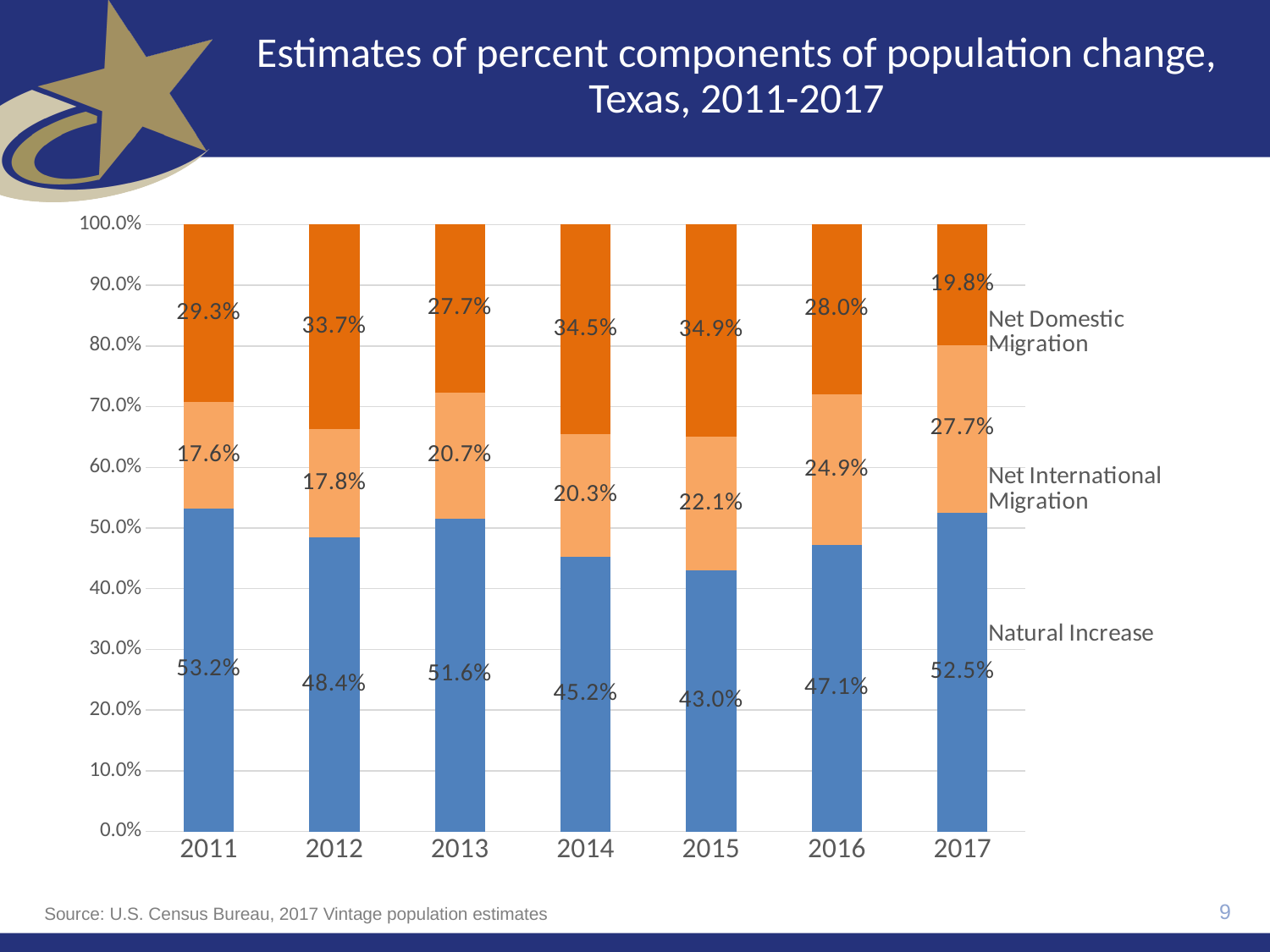
Which year has the highest Natural Increase share? 2011 What kind of chart is shown on the slide? Stacked bar chart Does the Net International Migration share rise or fall from 2013 to 2017? Rise What is the Net International Migration value for 2013? 20.7% What is the Natural Increase value for 2015? 43.0% What is the source cited below the chart? U.S. Census Bureau, 2017 Vintage population estimates Which is larger, the Net International Migration value for 2016 or for 2014? 2016 How many years are shown on the x axis? 7 How many series are shown in the chart? 3 What is the Net Domestic Migration value for 2017? 19.8% Which year has the lowest Net Domestic Migration share? 2017 What is the difference between the Net Domestic Migration values for 2015 and 2016? 6.9%